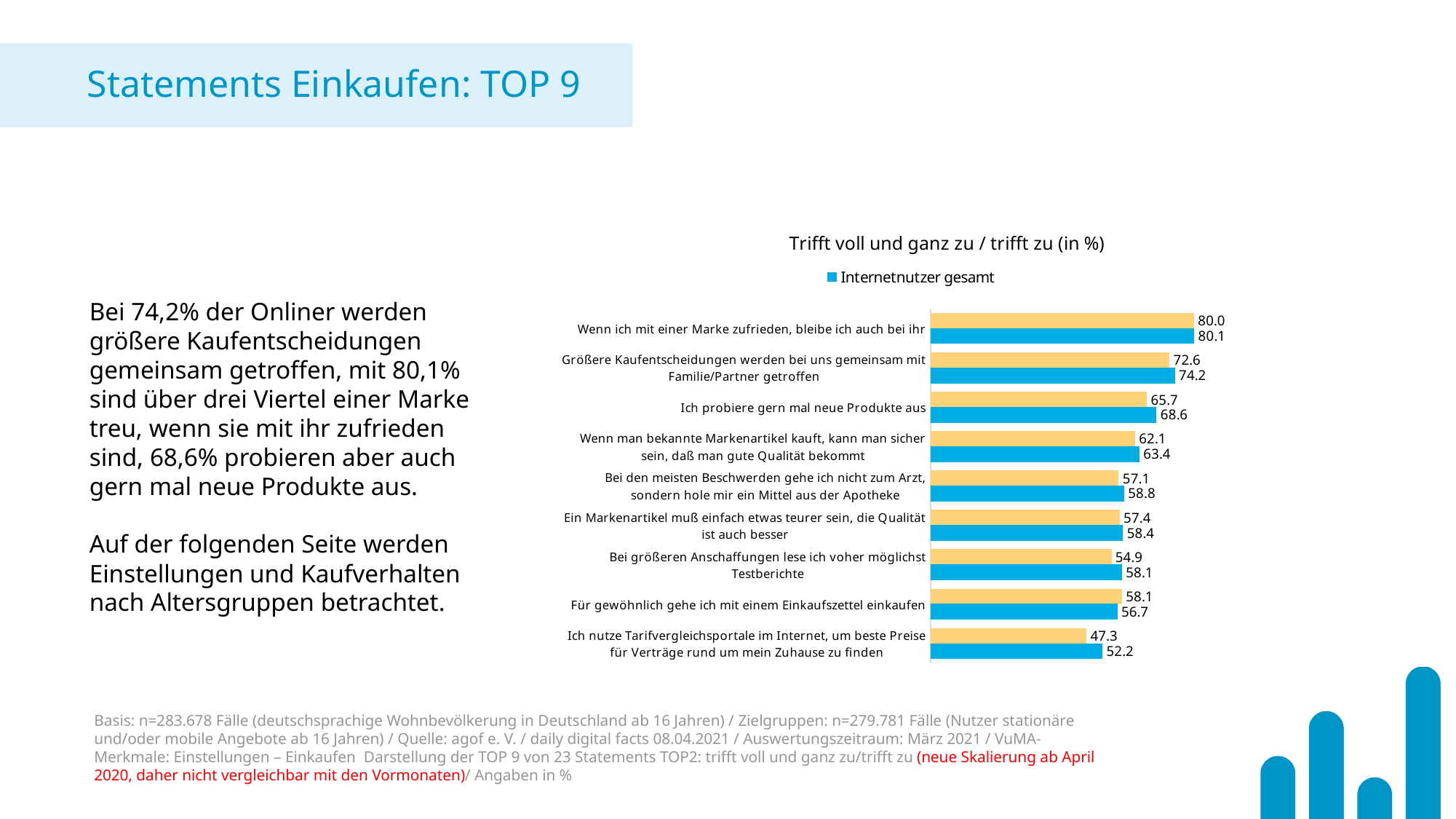
What kind of chart is shown on the slide? bar chart Which is larger for Internetnutzer gesamt: "Bei den meisten Beschwerden gehe ich nicht zum Arzt, sondern hole mir ein Mittel aus der Apotheke" or "Ich nutze Tarifvergleichsportale im Internet, um beste Preise für Verträge rund um mein Zuhause zu finden"? Bei den meisten Beschwerden gehe ich nicht zum Arzt, sondern hole mir ein Mittel aus der Apotheke What is the Internetnutzer gesamt value for "Ich nutze Tarifvergleichsportale im Internet, um beste Preise für Verträge rund um mein Zuhause zu finden"? 52.2 Which statement has the highest Internetnutzer gesamt value? Wenn ich mit einer Marke zufrieden, bleibe ich auch bei ihr How many series does the chart legend list? 1 For Internetnutzer gesamt, what is the difference between "Größere Kaufentscheidungen werden bei uns gemeinsam mit Familie/Partner getroffen" and "Ich probiere gern mal neue Produkte aus"? 5.6 Which statement has the lowest Internetnutzer gesamt value? Ich nutze Tarifvergleichsportale im Internet, um beste Preise für Verträge rund um mein Zuhause zu finden What is the Internetnutzer gesamt value for "Ich probiere gern mal neue Produkte aus"? 68.6 What is the difference between the highest and lowest Internetnutzer gesamt values? 27.9 What is the Internetnutzer gesamt value for "Wenn ich mit einer Marke zufrieden, bleibe ich auch bei ihr"? 80.1 For "Für gewöhnlich gehe ich mit einem Einkaufszettel einkaufen", which bar is larger, the yellow bar or the blue Internetnutzer gesamt bar? the yellow bar How many statements are shown in the chart? 9